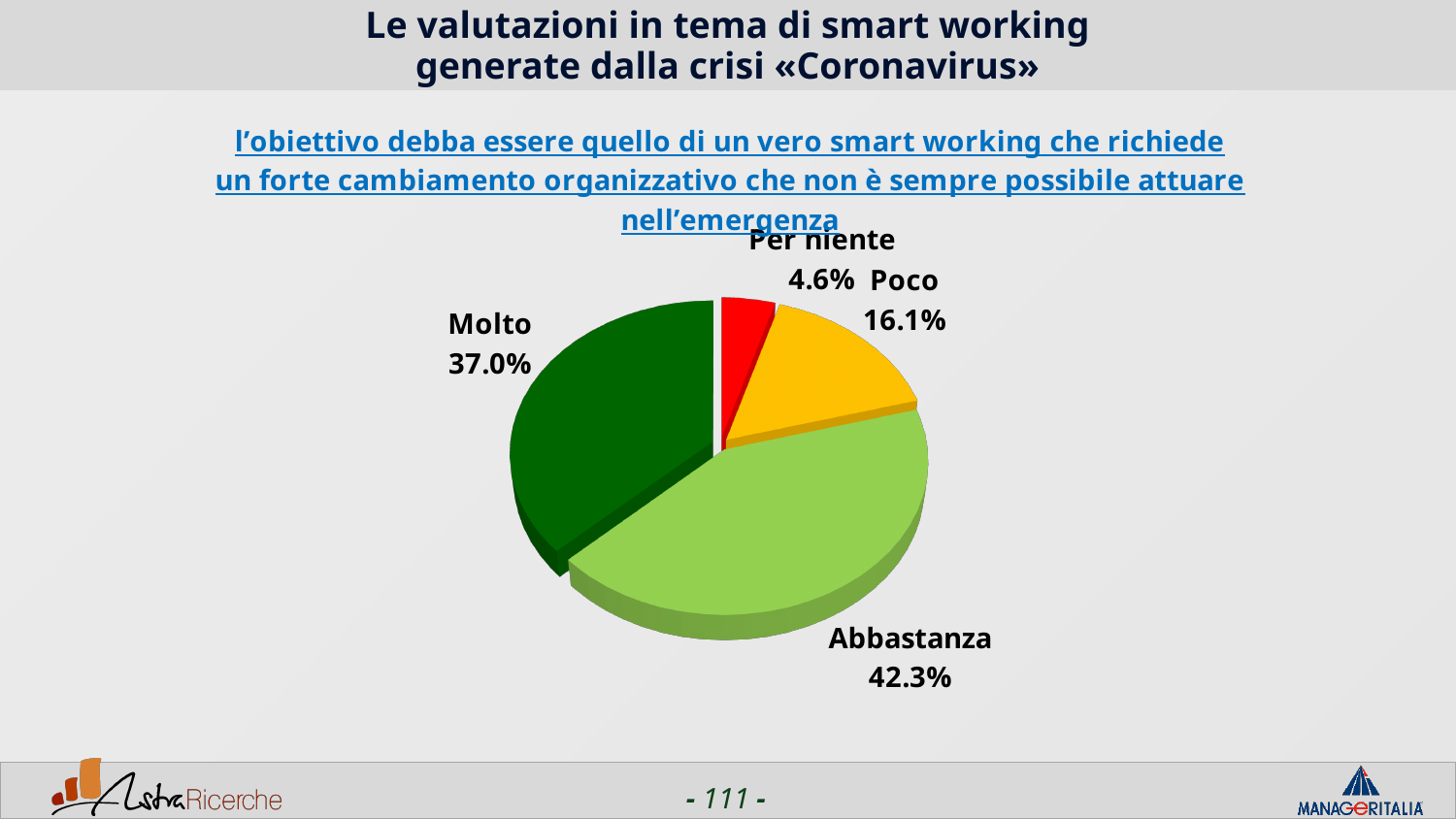
What percentage of the pie chart is labelled "Poco"? 16.1% Which is larger, the "Molto" slice or the "Poco" slice? Molto What colour is the "Per niente" slice of the pie chart? Red What kind of chart is shown on the slide? Pie chart Which slice of the pie chart is the largest? Abbastanza What is the difference in percentage points between the "Poco" and "Per niente" slices? 11.5 What is the difference in percentage points between the "Abbastanza" and "Molto" slices? 5.3 How many slices does the pie chart have? 4 What percentage of the pie chart is labelled "Molto"? 37.0% What percentage of the pie chart is labelled "Per niente"? 4.6% Which slice of the pie chart is the smallest? Per niente What percentage of the pie chart is labelled "Abbastanza"? 42.3%